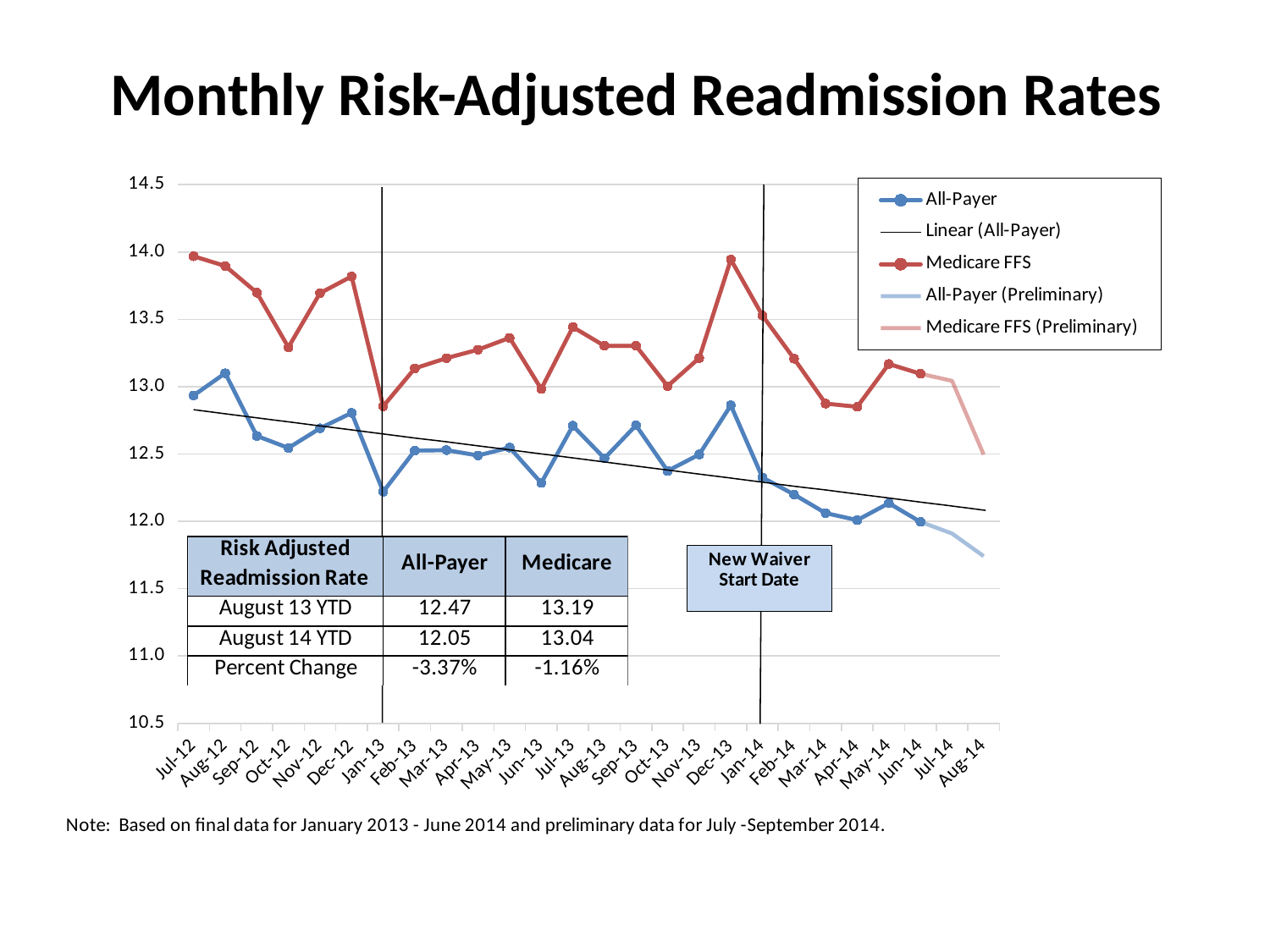
Which series is higher in Dec-13, All-Payer or Medicare FFS? Medicare FFS Is the All-Payer value for Jan-13 greater or less than 12.5? less How many monthly points are shown along the x axis, from Jul-12 to Aug-14? 26 Is the Medicare FFS value for Jan-13 greater or less than 13.0? less Does the All-Payer series generally rise or fall from Jul-12 to Aug-14? fall Is the All-Payer (Preliminary) value for Aug-14 greater or less than 12.0? less In which month does the All-Payer series reach its highest value? Aug-12 What kind of chart is shown on the slide? line chart According to the table on the chart, what is the percent change for Medicare? -1.16% How many series does the chart legend list? 5 According to the table on the chart, what is the All-Payer August 14 YTD risk adjusted readmission rate? 12.05